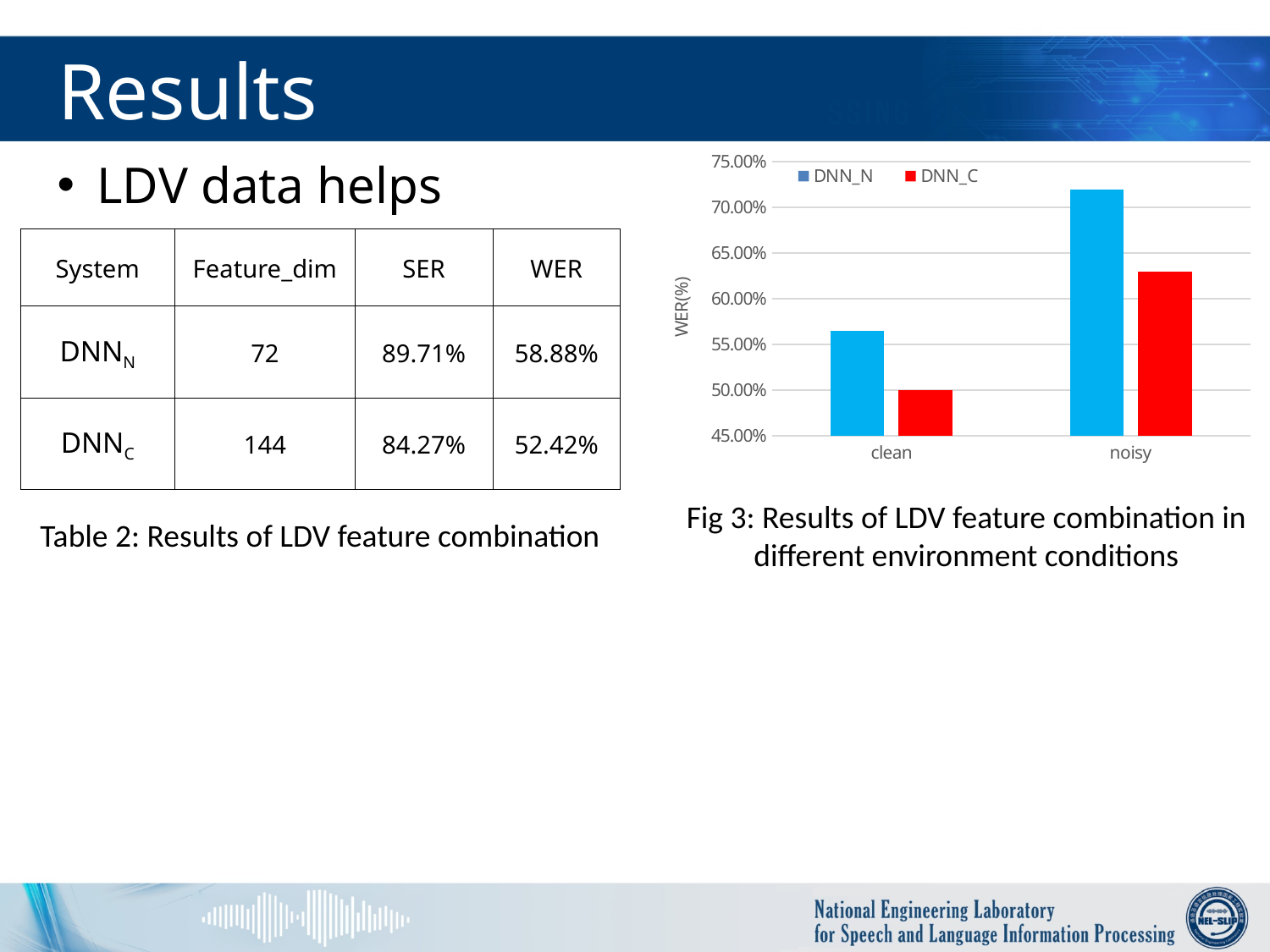
How many environment conditions are shown on the x axis of the chart? 2 What is the label on the y axis of the chart? WER(%) Which series has the highest WER in the noisy condition? DNN_N Does the WER for DNN_C rise or fall from the clean condition to the noisy condition? rise How many series does the legend of the chart list? 2 Is the WER for DNN_N in the noisy condition greater or less than 70.00%? greater Is the WER for DNN_C in the noisy condition greater or less than 65.00%? less In the clean condition, which series has the larger WER, DNN_N or DNN_C? DNN_N Is the WER for DNN_N in the clean condition greater or less than 55.00%? greater What colour are the DNN_C bars in the chart? red What kind of chart is shown in Fig 3? bar chart Which bar in the chart has the lowest WER? DNN_C in the clean condition